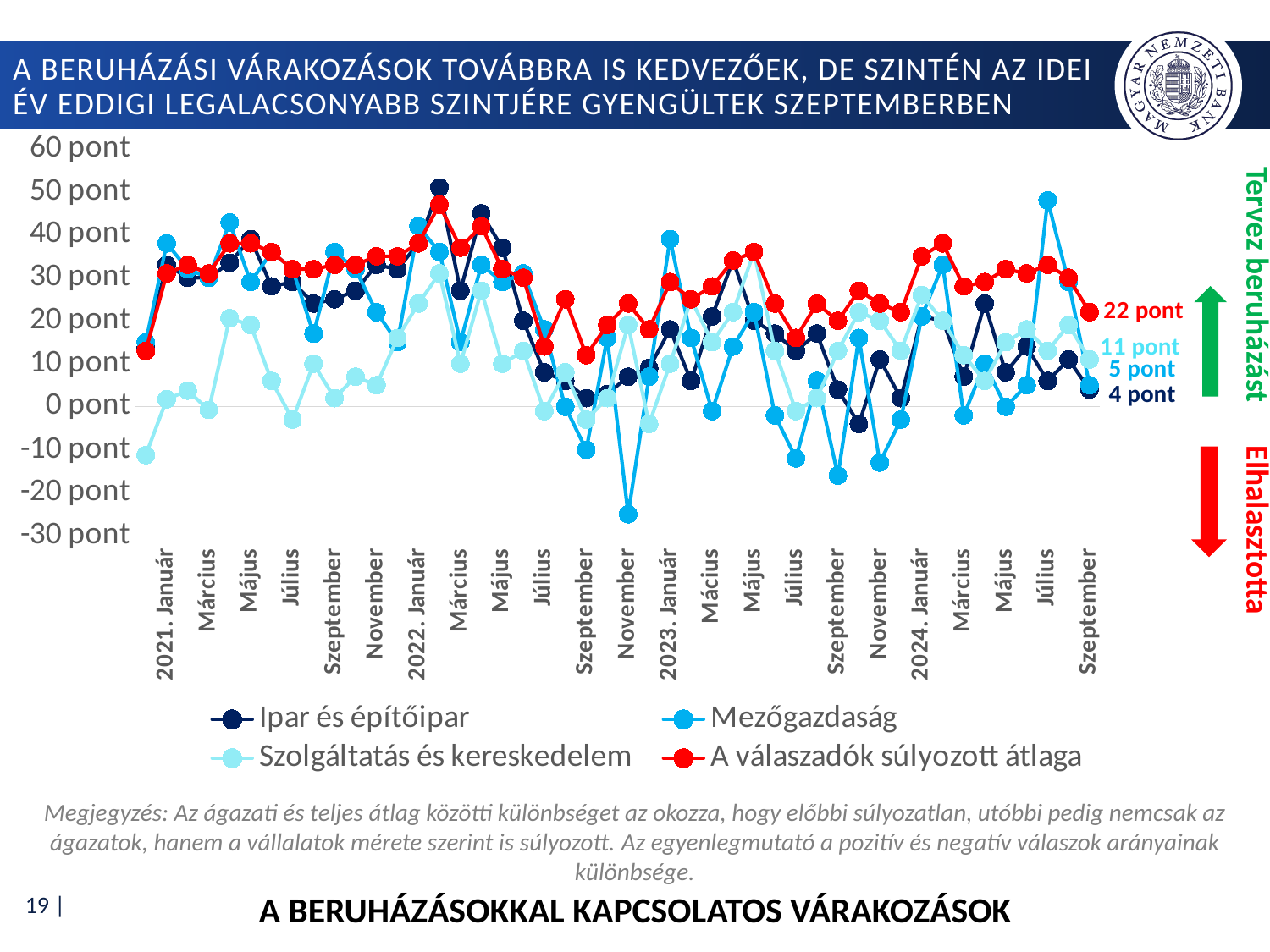
What kind of chart is shown on the slide? line chart Is the value for 'Mezőgazdaság' in 2024 Július greater or less than 40 pont? greater Which series has the highest value at the last point (2024 Szeptember)? A válaszadók súlyozott átlaga At the last point (2024 Szeptember), what is the difference between 'A válaszadók súlyozott átlaga' and 'Szolgáltatás és kereskedelem'? 11 pont Which series has the lowest value at the last point (2024 Szeptember)? Ipar és építőipar What is the value of 'Szolgáltatás és kereskedelem' at the last point (2024 Szeptember)? 11 pont What is the value of 'A válaszadók súlyozott átlaga' at the last point (2024 Szeptember)? 22 pont Is the value for 'Mezőgazdaság' in 2022 November greater or less than -20 pont? less How many series does the legend list? 4 What is the value of 'Mezőgazdaság' at the last point (2024 Szeptember)? 5 pont At the last point (2024 Szeptember), which is larger: 'A válaszadók súlyozott átlaga' or 'Ipar és építőipar'? A válaszadók súlyozott átlaga What is the value of 'Ipar és építőipar' at the last point (2024 Szeptember)? 4 pont